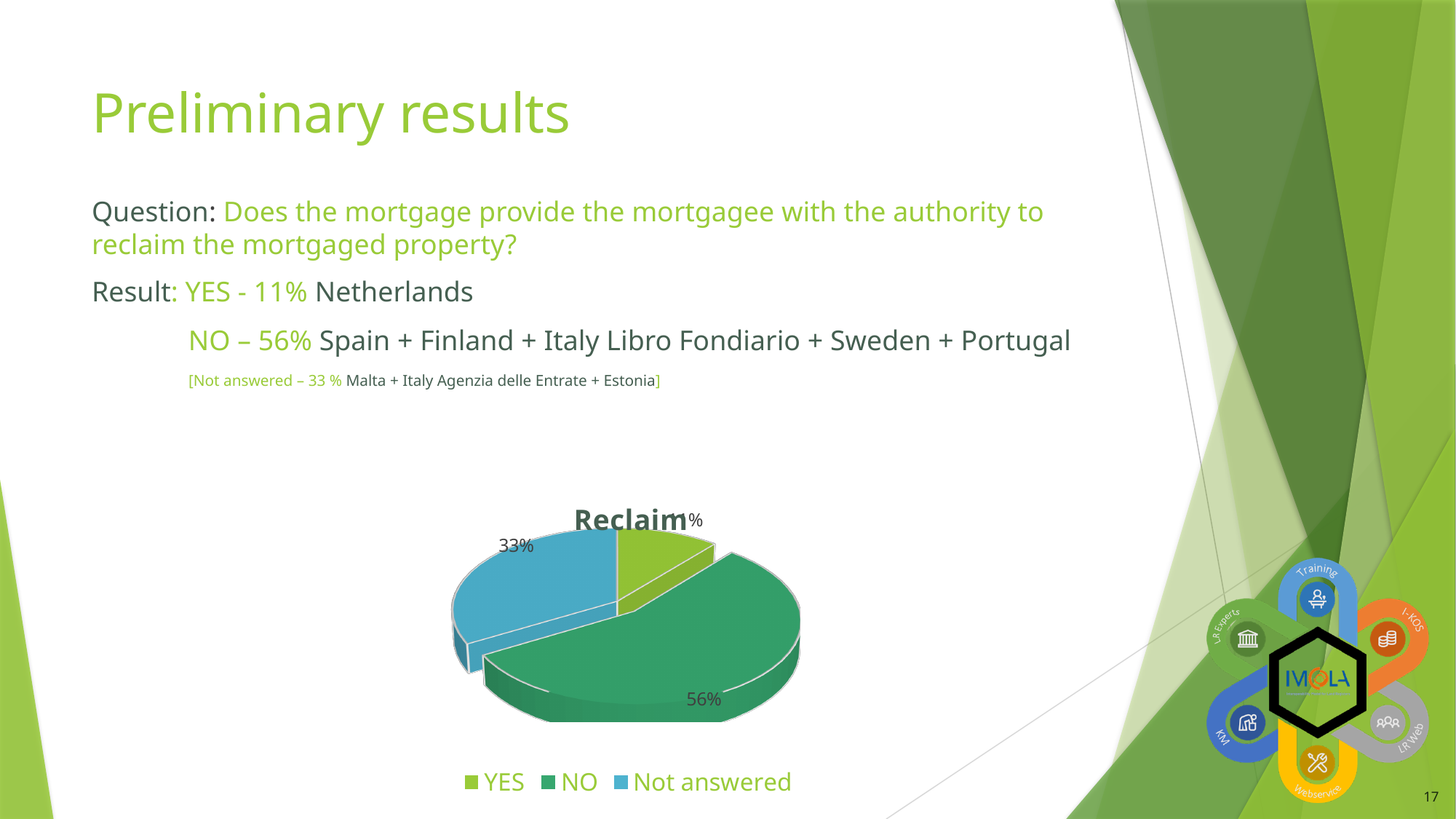
What colour is the Not answered slice in the pie chart? blue Which slice of the pie chart is the smallest? YES What percentage of the pie does the NO slice represent? 56% What is the title of the chart? Reclaim How many entries does the chart legend list? 3 Which is larger, the NO slice or the Not answered slice? NO Which slice of the pie chart is the largest? NO What percentage of the pie does the YES slice represent? 11% What kind of chart is shown on the slide? pie chart How many slices does the pie chart have? 3 What is the difference between the NO share and the Not answered share? 23% What percentage of the pie does the Not answered slice represent? 33%